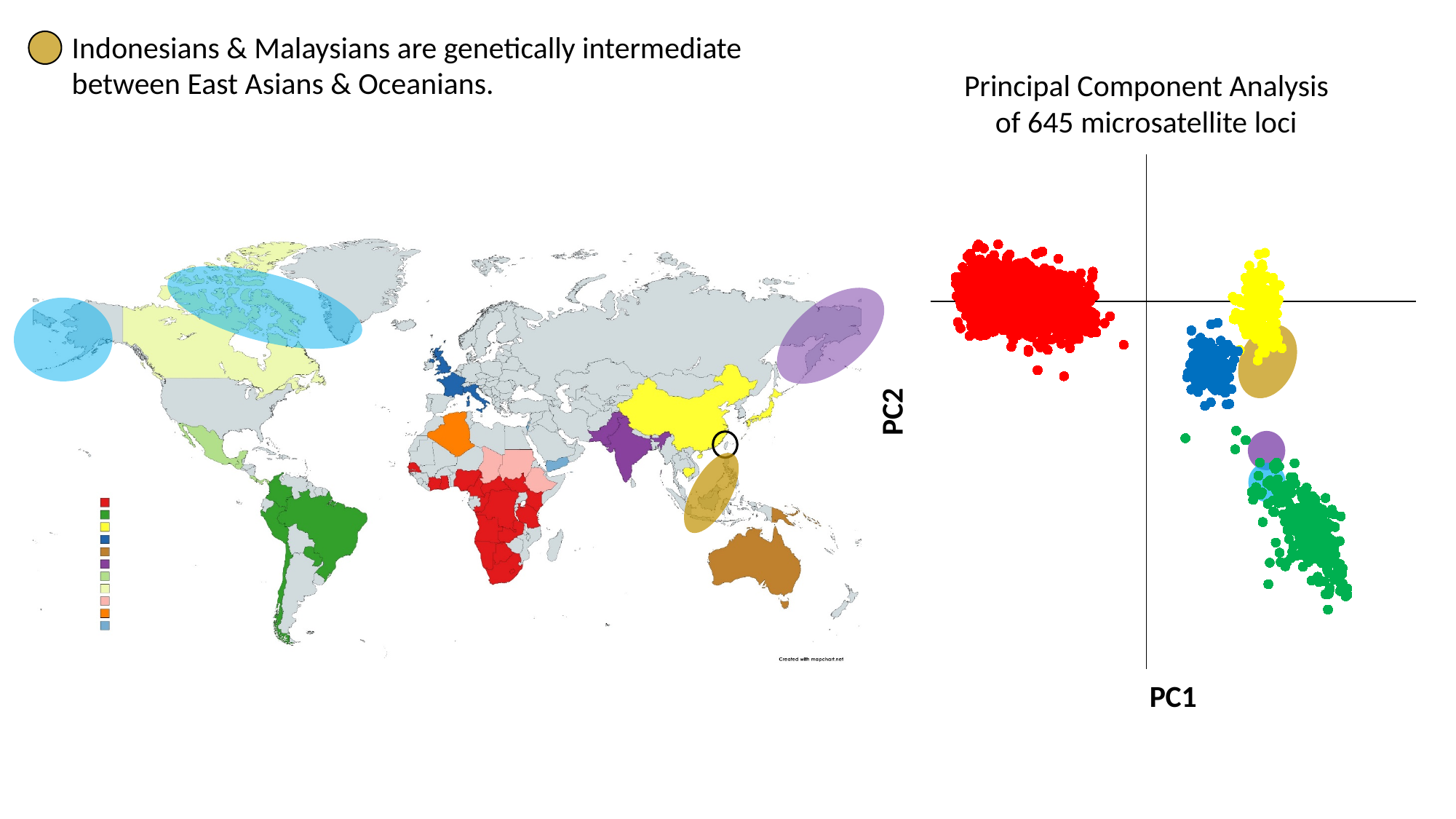
In the Principal Component Analysis chart, is the blue cluster to the left or to the right of the vertical PC2 axis? right In the Principal Component Analysis chart, which colour cluster extends lowest along PC2? green In the Principal Component Analysis chart, which colour cluster lies furthest to the left along PC1? red What is the title of the chart on the right of the slide? Principal Component Analysis of 645 microsatellite loci In the Principal Component Analysis chart, is the red cluster to the left or to the right of the vertical PC2 axis? left What kind of chart is the Principal Component Analysis on the right of the slide? scatter plot In the Principal Component Analysis chart, is the green cluster above or below the horizontal PC1 axis? below According to the chart title on the right, how many microsatellite loci were analysed? 645